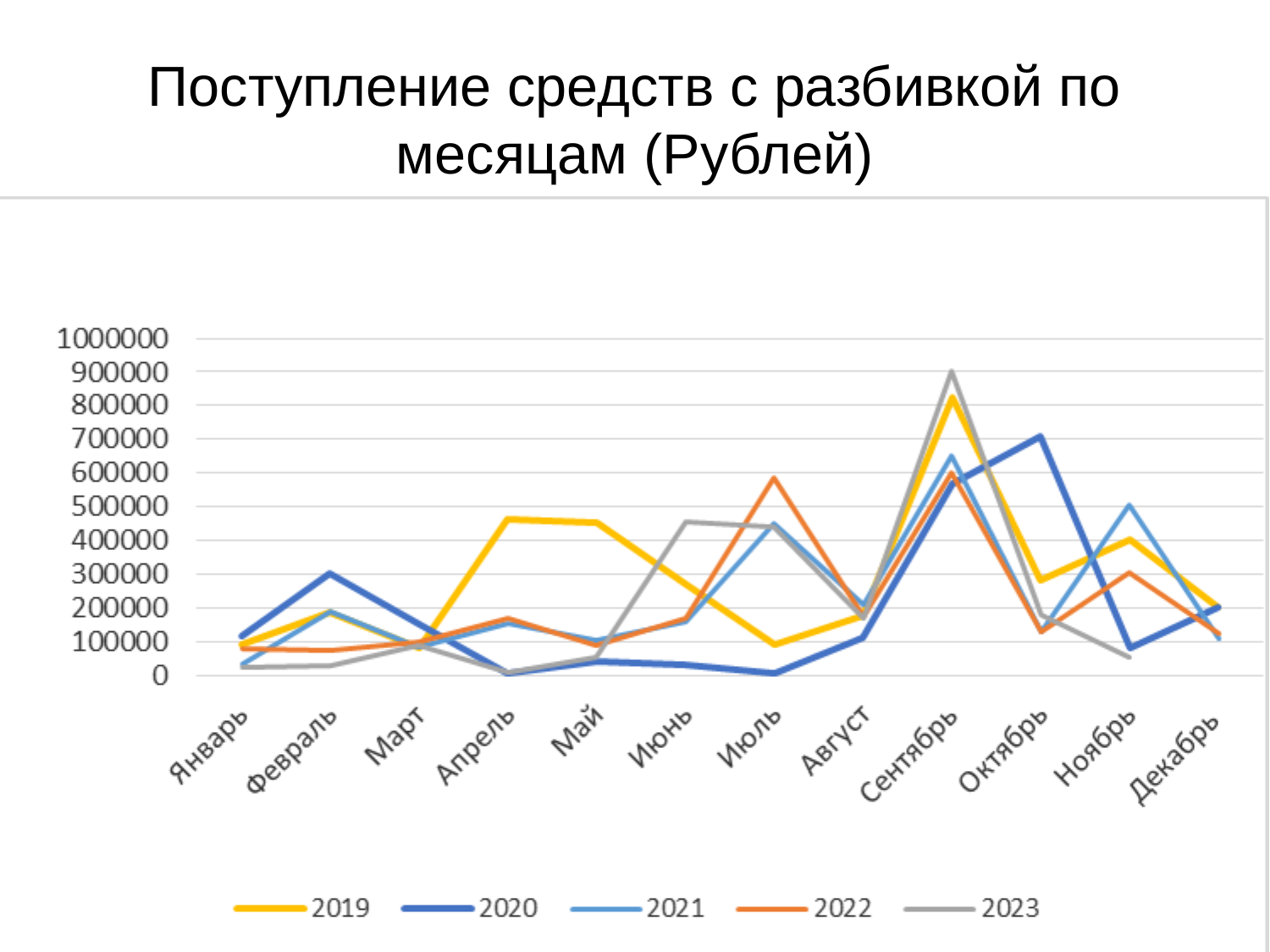
Which month has the highest value for the 2021 series? Сентябрь Is the value for 2020 in Октябрь greater or less than 600000? greater Is the value for 2022 in Июль greater or less than 500000? greater Which month has the highest value for the 2023 series? Сентябрь Is the value for 2020 in Июль greater or less than 100000? less Does the 2019 series rise or fall from Апрель to Июль? fall Which month has the highest value for the 2020 series? Октябрь What kind of chart is shown on the slide? line chart How many series does the legend list? 5 Which series has the larger value in Апрель, 2019 or 2020? 2019 How many months are plotted along the x axis? 12